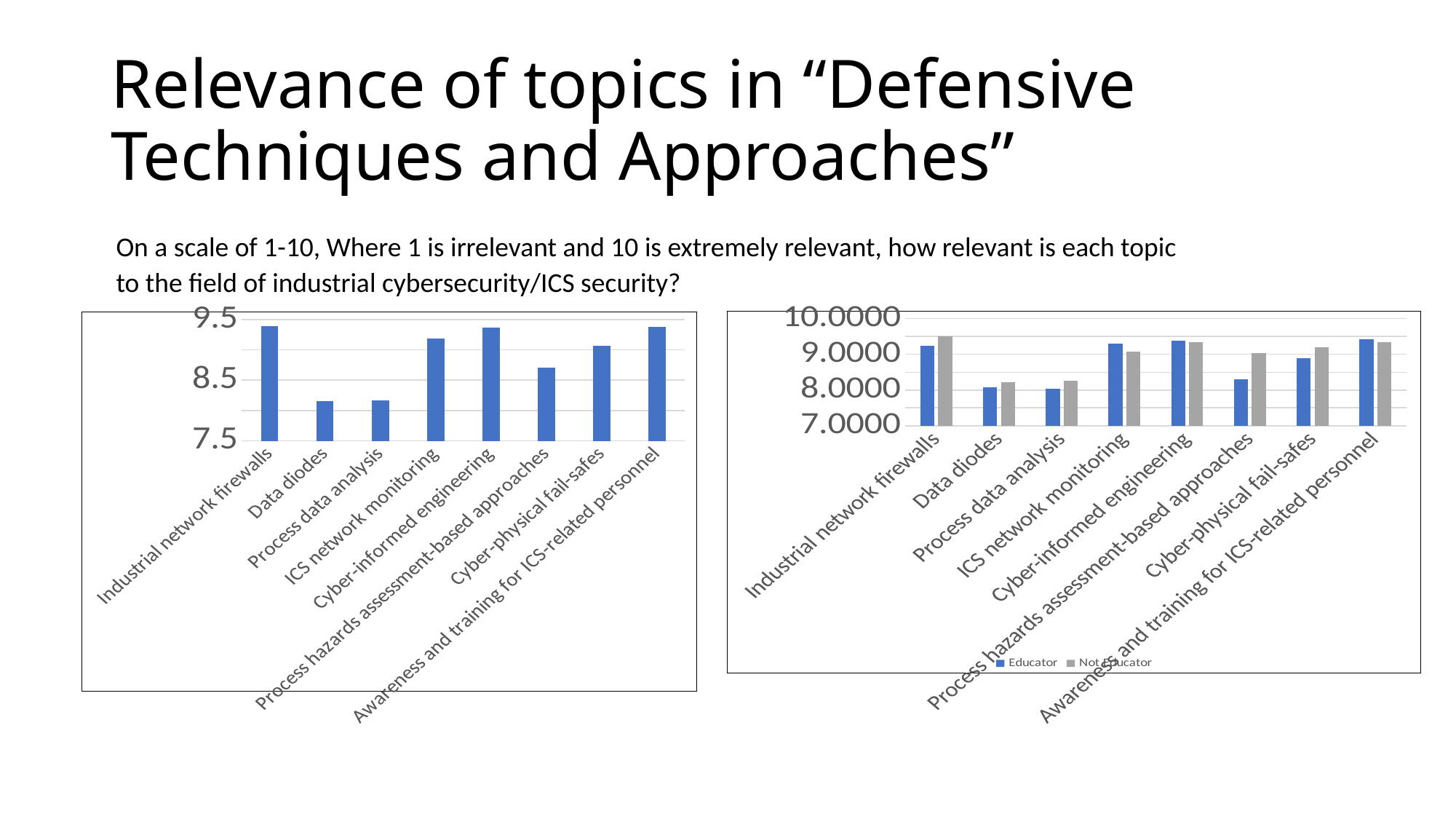
How many topics are shown on the x axis of the left chart? 8 In the left chart, which is larger: the value for Industrial network firewalls or the value for Data diodes? Industrial network firewalls What are the two series named in the legend of the right chart? Educator and Not Educator In the left chart, is the value for Cyber-physical fail-safes greater or less than 8.5? greater In the left chart, is the value for Data diodes greater or less than 8.5? less In the right chart, is the Educator value for Process hazards assessment-based approaches greater or less than 9.0000? less In the right chart, for Industrial network firewalls, which series has the larger value: Educator or Not Educator? Not Educator What kind of chart is the chart on the left of the slide? bar chart How many series does the legend of the right chart list? 2 In the left chart, which is larger: the value for ICS network monitoring or the value for Process hazards assessment-based approaches? ICS network monitoring